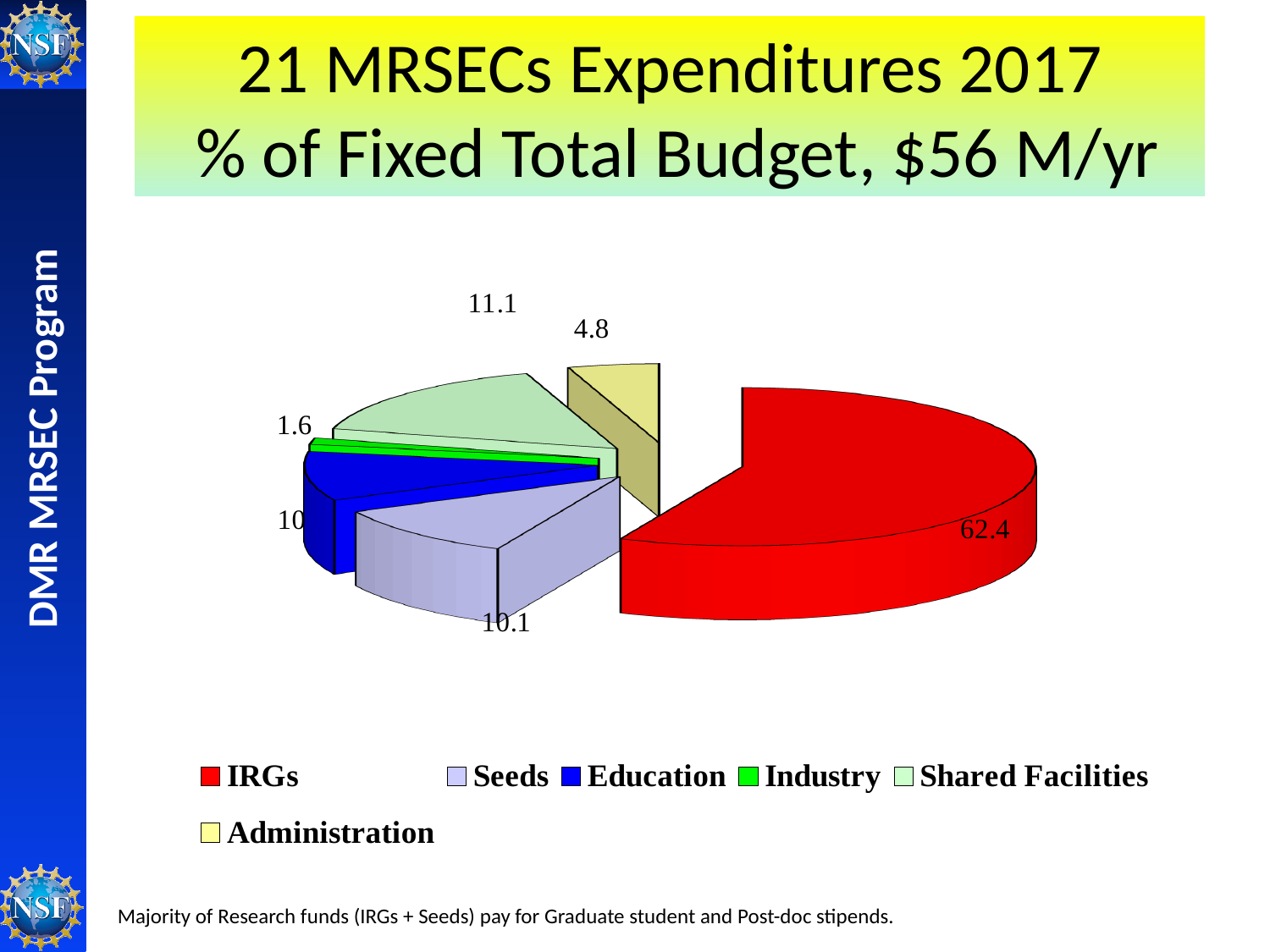
Which is larger, the value for Shared Facilities or the value for Seeds? Shared Facilities Which category has the smallest share of expenditures? Industry What kind of chart is shown on the slide? Pie chart What value is shown for Industry? 1.6 What colour represents IRGs in the chart? Red Which category has the largest share of expenditures? IRGs What value is shown for Shared Facilities? 11.1 How many categories does the legend list? 6 What value is shown for Administration? 4.8 What percentage of the budget goes to IRGs? 62.4 What value is shown for Seeds? 10.1 What is the difference between the IRGs value and the Seeds value? 52.3